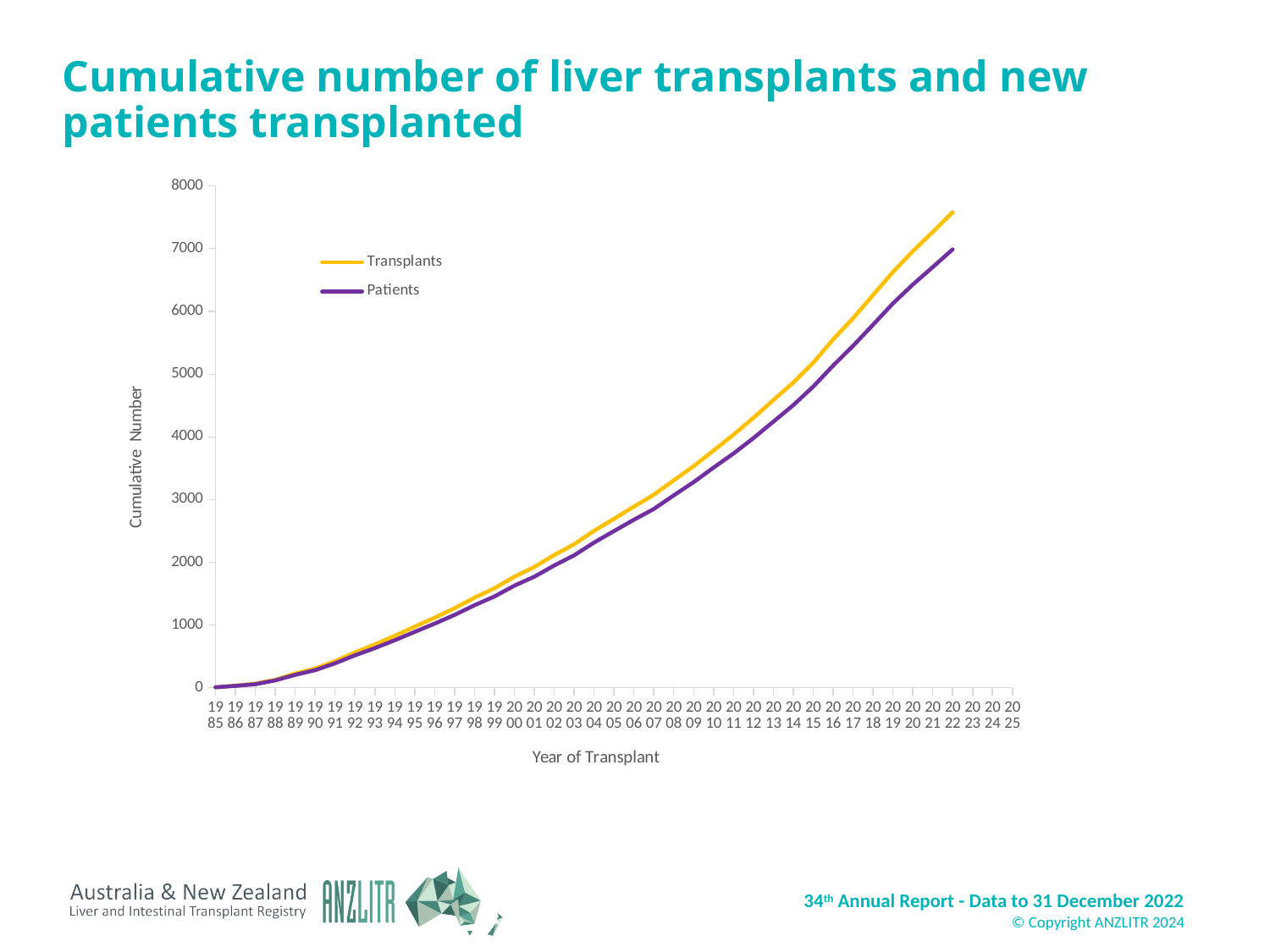
What are the two series named in the legend? Transplants and Patients What colour is the Transplants line? Yellow In 2022, which series has the larger value, Transplants or Patients? Transplants Is the Transplants value for 1990 greater or less than 1000? less Is the Transplants value for 2022 greater or less than 7000? greater In which year does the Transplants line reach its highest value? 2022 What kind of chart is shown on the slide? Line chart Is the Patients value for 2022 greater or less than 6000? greater How many series does the legend list? 2 Do the cumulative values rise or fall as the year of transplant increases? Rise